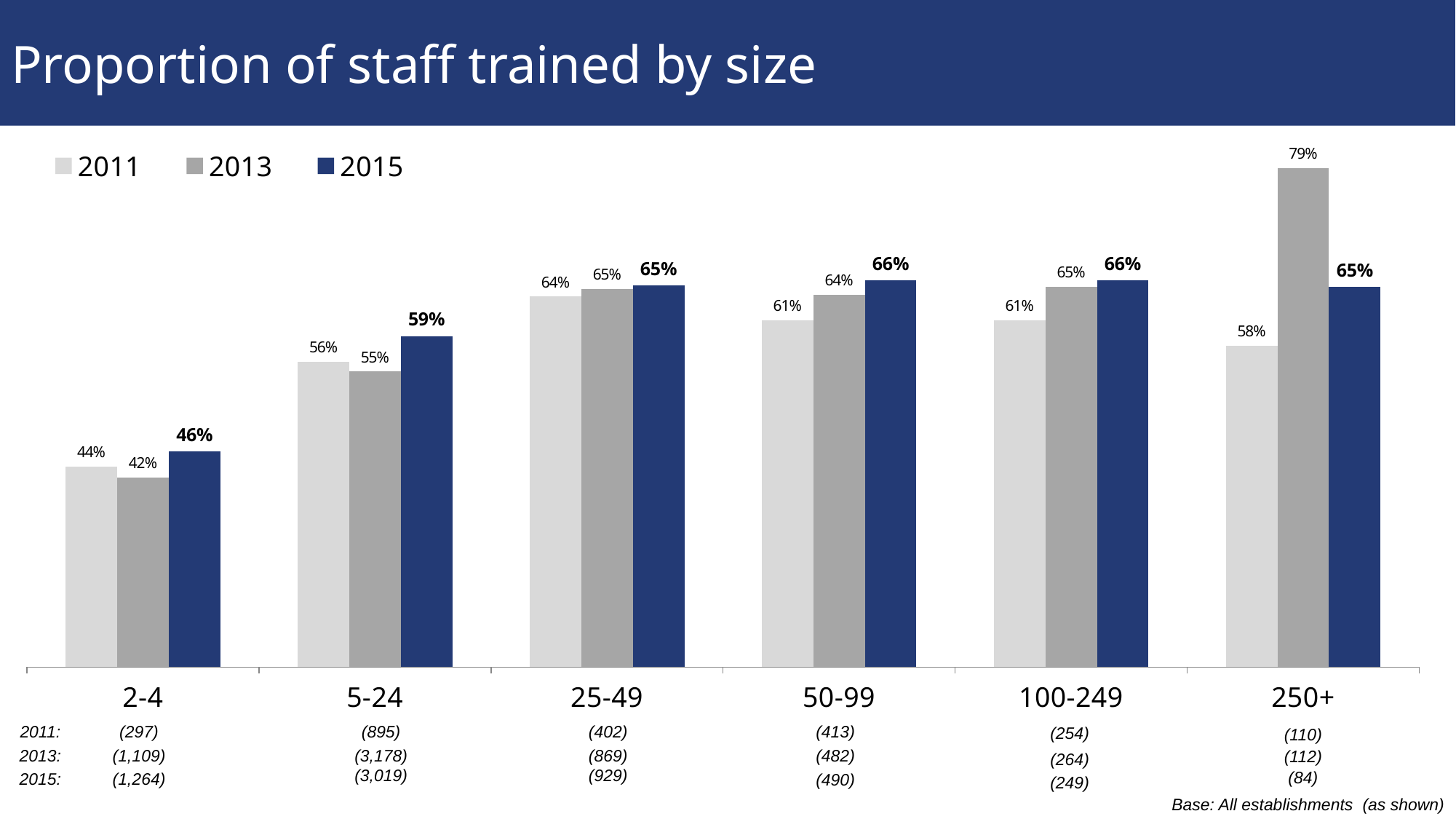
How many size bands are shown on the x axis? 6 What is the value for the 2013 series in the 250+ size band? 79% What kind of chart is shown on the slide? Bar chart What is the difference between the 2013 and 2015 values in the 250+ size band? 14 percentage points Which series is shown in dark blue? 2015 What is the value for the 2011 series in the 5-24 size band? 56% Which is larger in the 5-24 size band: the 2011 value or the 2013 value? 2011 How many series does the legend list? 3 What is the value for the 2015 series in the 2-4 size band? 46% What is the title of the chart? Proportion of staff trained by size Which size band has the lowest value for the 2015 series? 2-4 Which size band has the highest value for the 2013 series? 250+